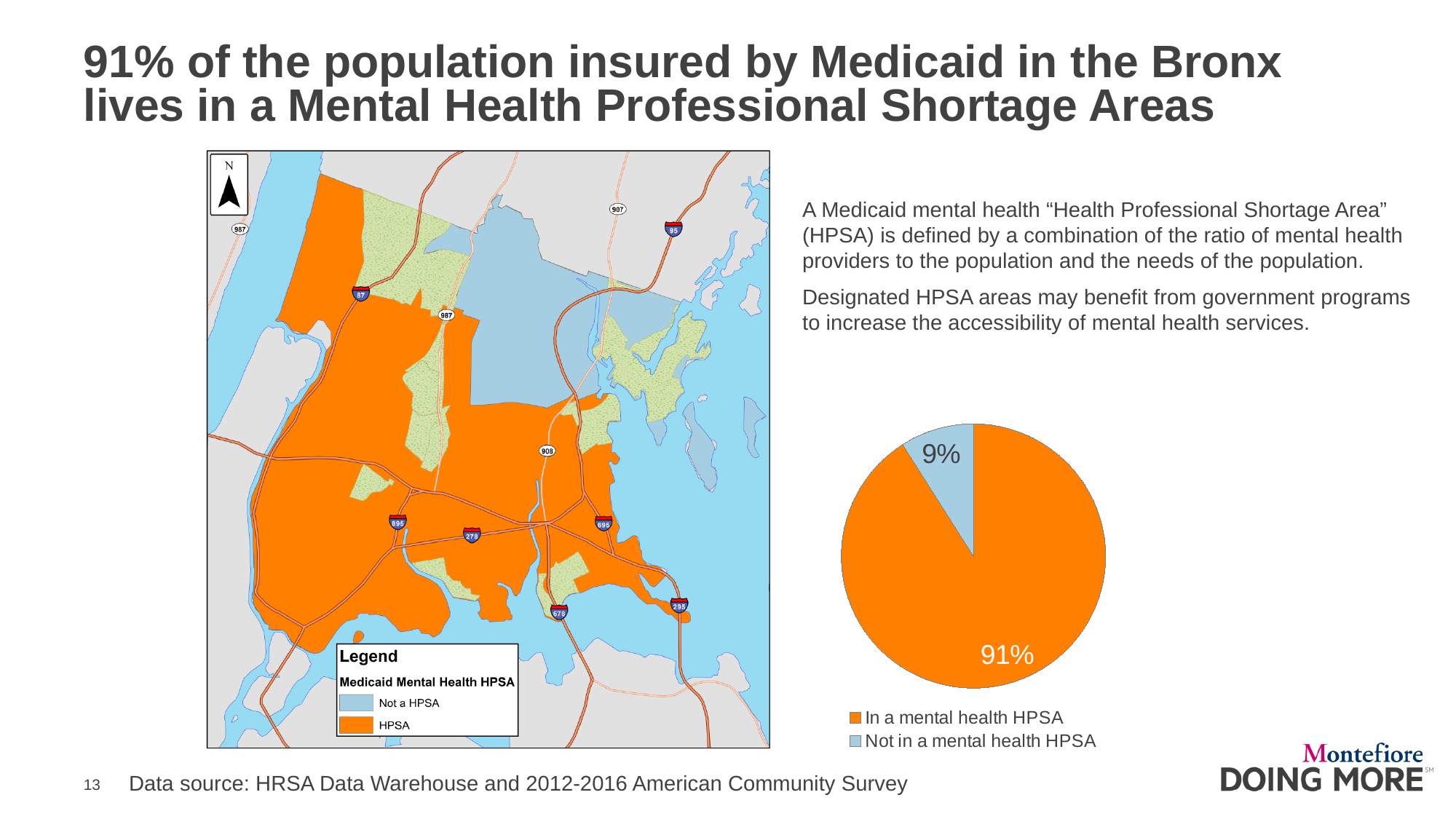
In the pie chart, which slice is the largest? In a mental health HPSA In the pie chart, what colour is the 'In a mental health HPSA' slice? orange How many slices does the pie chart have? 2 In the pie chart, which slice is the smallest? Not in a mental health HPSA In the pie chart, what colour is the 'Not in a mental health HPSA' slice? light blue In the pie chart, which is larger: the share in a mental health HPSA or the share not in a mental health HPSA? In a mental health HPSA How many entries does the pie chart's legend list? 2 In the pie chart, what share of the population is not in a mental health HPSA? 9% In the pie chart, what is the difference in percentage points between the 'In a mental health HPSA' slice and the 'Not in a mental health HPSA' slice? 82 What kind of chart is shown on the right side of the slide? pie chart In the pie chart, what share of the population is in a mental health HPSA? 91%